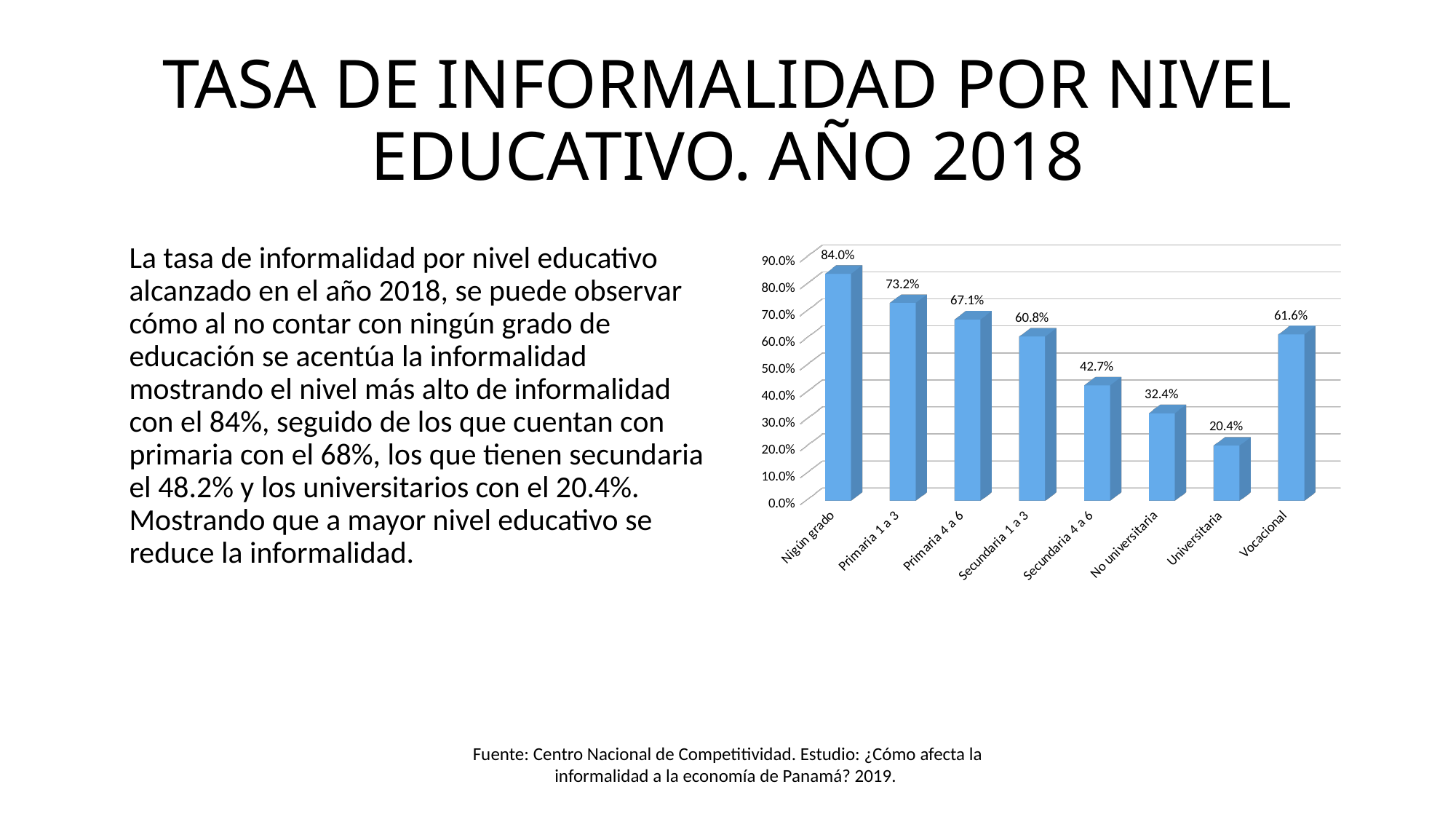
What is the informality rate for Vocacional? 61.6% Which education level has the highest informality rate? Ningún grado What is the highest value shown on the vertical axis of the chart? 90.0% What is the informality rate for Ningún grado? 84.0% How many education levels are shown in the chart? 8 What is the informality rate for Secundaria 4 a 6? 42.7% What kind of chart is shown on the slide? Bar chart Which has a higher informality rate, Secundaria 1 a 3 or Vocacional? Vocacional Which education level has the lowest informality rate? Universitaria Is the value for No universitaria greater or less than 40.0%? less What is the informality rate for Universitaria? 20.4% What is the difference between the informality rates for Primaria 1 a 3 and Primaria 4 a 6? 6.1%